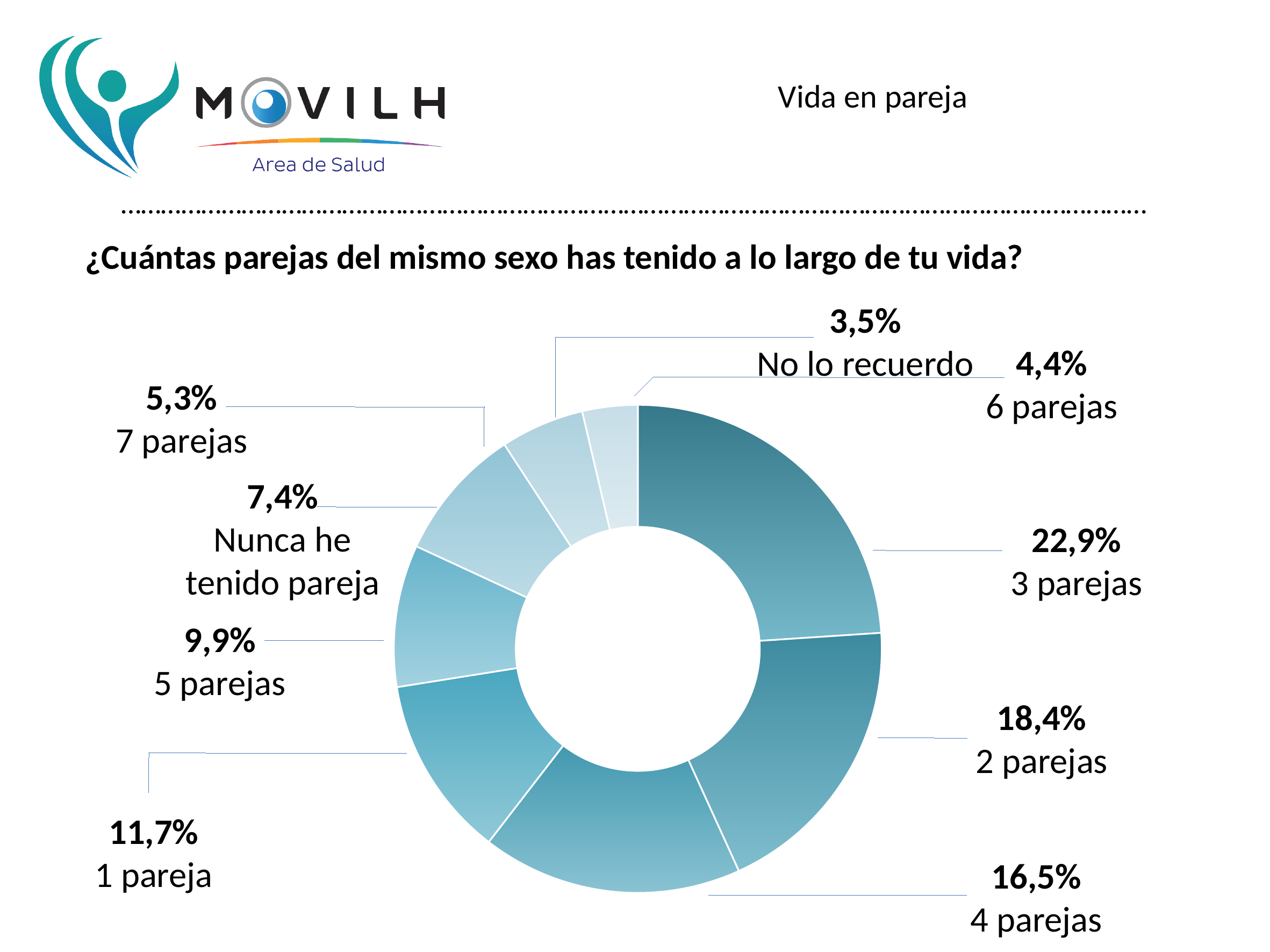
Which category has the smallest share of the chart? No lo recuerdo What kind of chart is shown on the slide? Doughnut chart Which category has the largest share of the chart? 3 parejas What percentage of respondents reported having had 3 parejas? 22,9% What question does the chart answer, according to the slide heading? ¿Cuántas parejas del mismo sexo has tenido a lo largo de tu vida? What is the combined share of '1 pareja' and '2 parejas'? 30,1% How many categories does the chart show? 9 What share is labelled 'Nunca he tenido pareja'? 7,4% What percentage is shown for 'No lo recuerdo'? 3,5% What percentage corresponds to '1 pareja'? 11,7% Which is larger, the share for '5 parejas' or the share for '7 parejas'? 5 parejas What is the difference in percentage points between '3 parejas' and '2 parejas'? 4,5